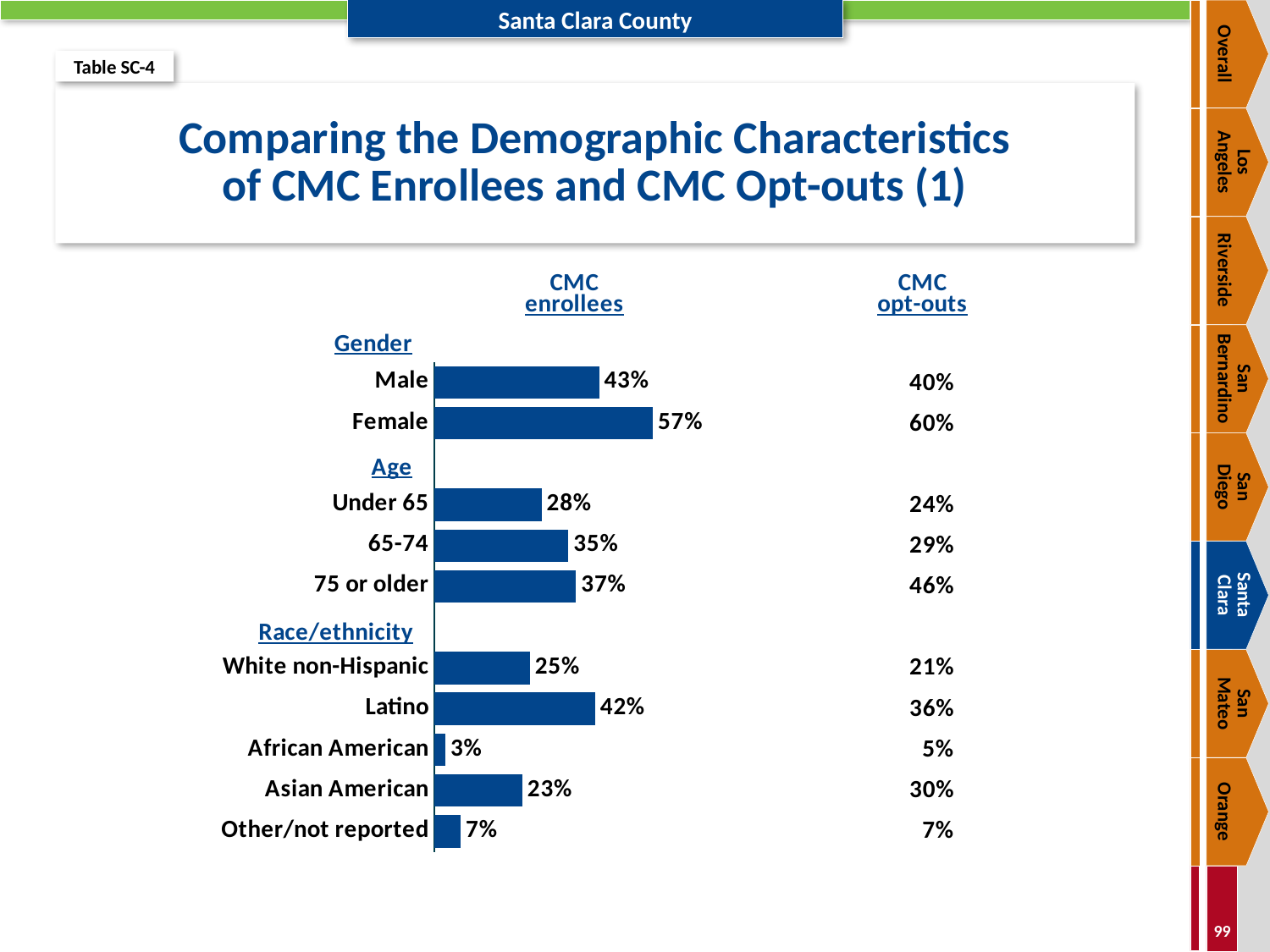
What is the title of the slide? Comparing the Demographic Characteristics of CMC Enrollees and CMC Opt-outs (1) Which has a larger CMC enrollees value, Asian American or White non-Hispanic? White non-Hispanic What kind of chart is used to show the CMC enrollees values? Bar chart What is the CMC enrollees value for Female? 57% What is the CMC enrollees value for 65-74? 35% What is the CMC enrollees value for Latino? 42% How many categories have bars in the CMC enrollees chart? 10 Which race/ethnicity category has the lowest CMC enrollees value? African American What is the difference between the CMC enrollees values for Female and Male? 14% Which has a larger CMC enrollees value, Under 65 or 75 or older? 75 or older Which age category has the highest CMC enrollees value? 75 or older What is the difference between the CMC enrollees values for Latino and White non-Hispanic? 17%